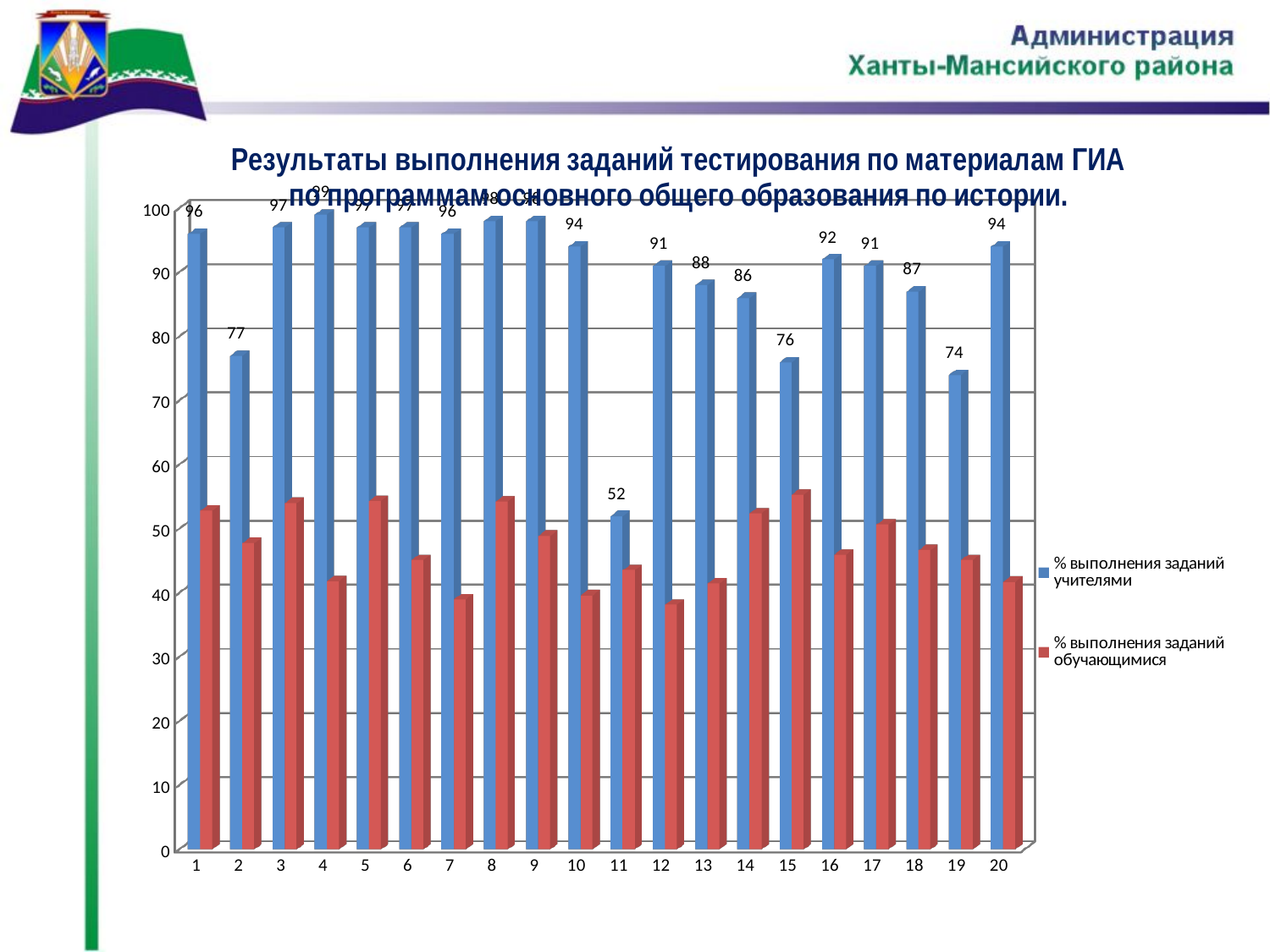
What is the value for category 16 in the series "% выполнения заданий учителями"? 92 In the series "% выполнения заданий учителями", which is larger: category 15 or category 19? 15 Which category has the lowest value in the series "% выполнения заданий учителями"? 11 Is the value for category 12 in the series "% выполнения заданий обучающимися" greater or less than 40? less What is the difference between the values for categories 2 and 11 in the series "% выполнения заданий учителями"? 25 What is the value for category 11 in the series "% выполнения заданий учителями"? 52 How many categories are shown on the x axis? 20 What is the value for category 19 in the series "% выполнения заданий учителями"? 74 How many series does the legend list? 2 What kind of chart is shown on the slide? bar chart What is the value for category 2 in the series "% выполнения заданий учителями"? 77 Is the value for category 15 in the series "% выполнения заданий обучающимися" greater or less than 50? greater